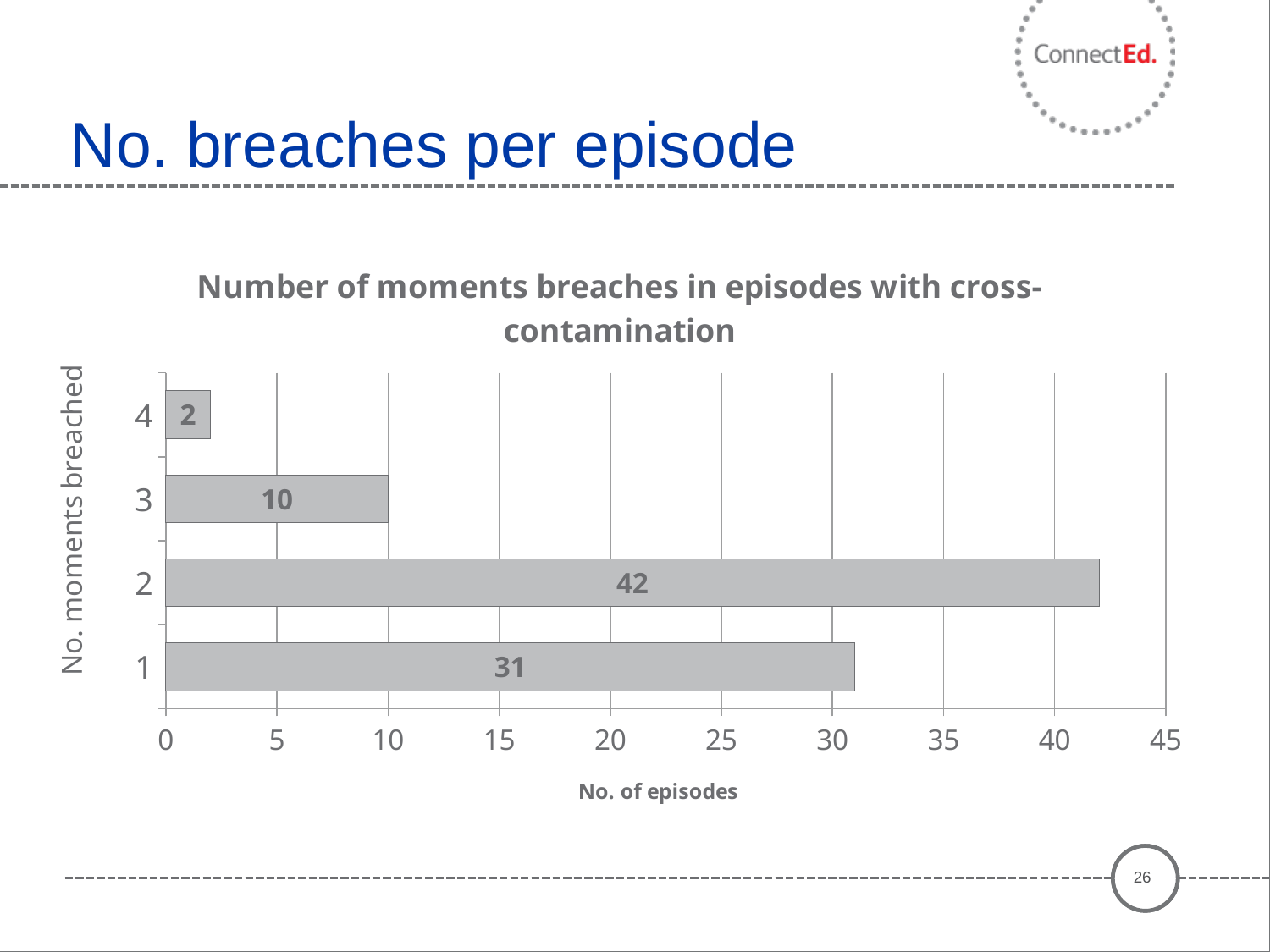
What is the label of the horizontal axis of the chart? No. of episodes What kind of chart is shown on the slide? Bar chart What is the total number of episodes across all four bars? 85 How many episodes had 1 moment breached? 31 What is the difference in number of episodes between 2 moments breached and 1 moment breached? 11 Which number of moments breached has the highest number of episodes? 2 Which has more episodes: 3 moments breached or 4 moments breached? 3 moments breached How many episodes had 4 moments breached? 2 How many categories (numbers of moments breached) are shown in the chart? 4 Which number of moments breached has the lowest number of episodes? 4 Is the number of episodes with 1 moment breached greater or less than 30? greater How many episodes had 2 moments breached? 42